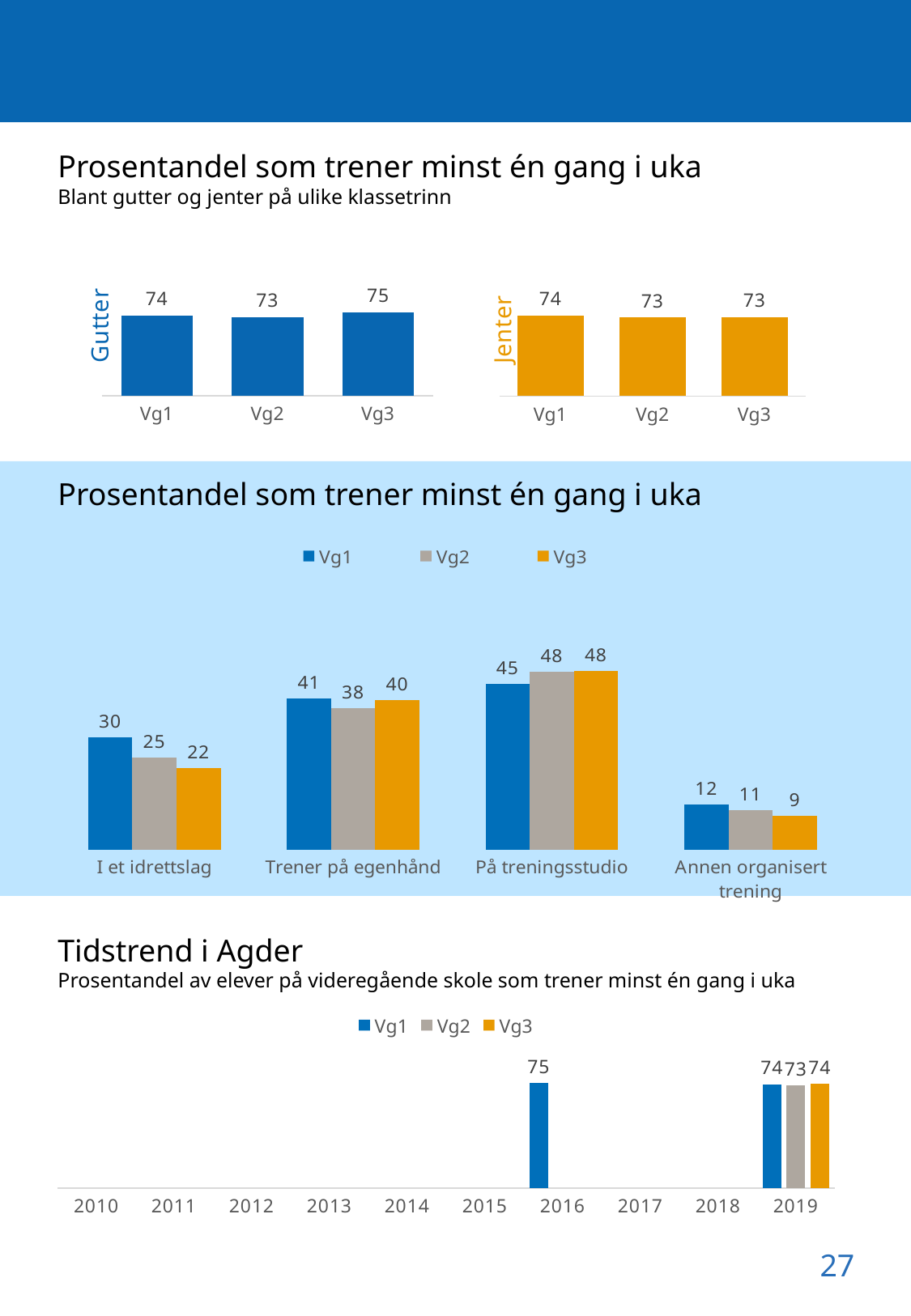
In the middle chart 'Prosentandel som trener minst én gang i uka', is the Vg1 value for 'Annen organisert trening' larger or smaller than the Vg3 value? larger In the middle chart 'Prosentandel som trener minst én gang i uka', how many series does the legend list? 3 In the bottom chart 'Tidstrend i Agder', what is the Vg1 value for 2016? 75 In the top-left 'Gutter' chart, which class level has the lowest value? Vg2 In the middle chart 'Prosentandel som trener minst én gang i uka', how many categories are shown on the x axis? 4 What kind of chart is the bottom chart 'Tidstrend i Agder'? bar chart In the middle chart 'Prosentandel som trener minst én gang i uka', what is the difference between the Vg1 and Vg3 values for 'I et idrettslag'? 8 In the middle chart 'Prosentandel som trener minst én gang i uka', which category has the highest Vg1 value? På treningsstudio In the middle chart 'Prosentandel som trener minst én gang i uka', what is the Vg2 value for 'Trener på egenhånd'? 38 In the top-left 'Gutter' chart, what is the value for Vg3? 75 In the middle chart 'Prosentandel som trener minst én gang i uka', what is the Vg3 value for 'I et idrettslag'? 22 In the top-right 'Jenter' chart, what is the value for Vg1? 74